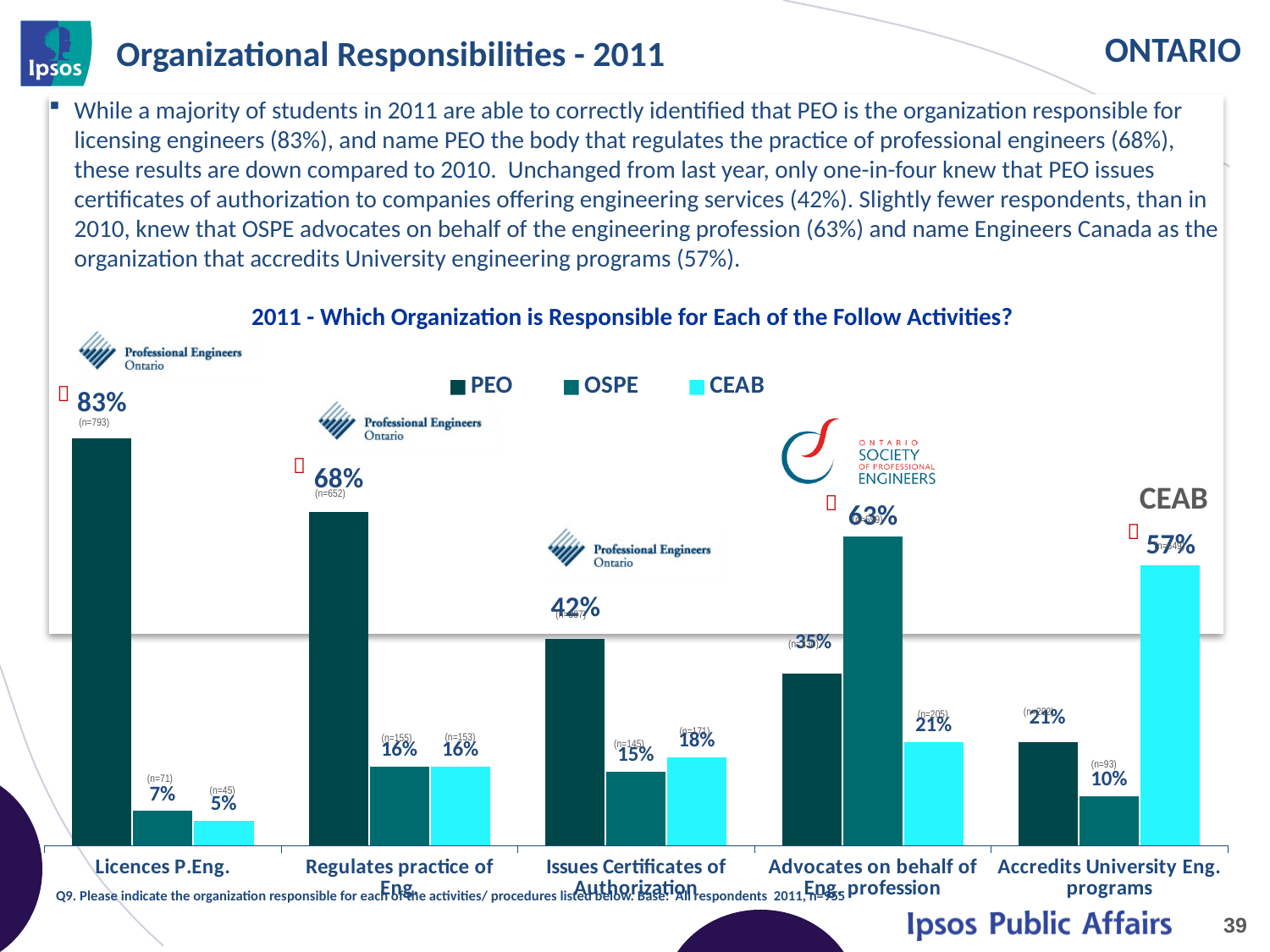
How many series does the legend list? 3 What is the CEAB value for 'Accredits University Eng. programs'? 57% What percentage of respondents named PEO as responsible for Licences P.Eng.? 83% What is the OSPE value for 'Advocates on behalf of Eng. profession'? 63% Which organization has the highest value for 'Regulates practice of Eng.'? PEO What is the PEO value for 'Issues Certificates of Authorization'? 42% How many activity categories are shown on the x axis? 5 Which organization has the lowest value for 'Licences P.Eng.'? CEAB For 'Advocates on behalf of Eng. profession', which is larger: the PEO value or the OSPE value? OSPE What kind of chart is shown on the slide? Bar chart What is the difference between the PEO and OSPE values for 'Licences P.Eng.'? 76% What is the title of the chart? 2011 - Which Organization is Responsible for Each of the Follow Activities?